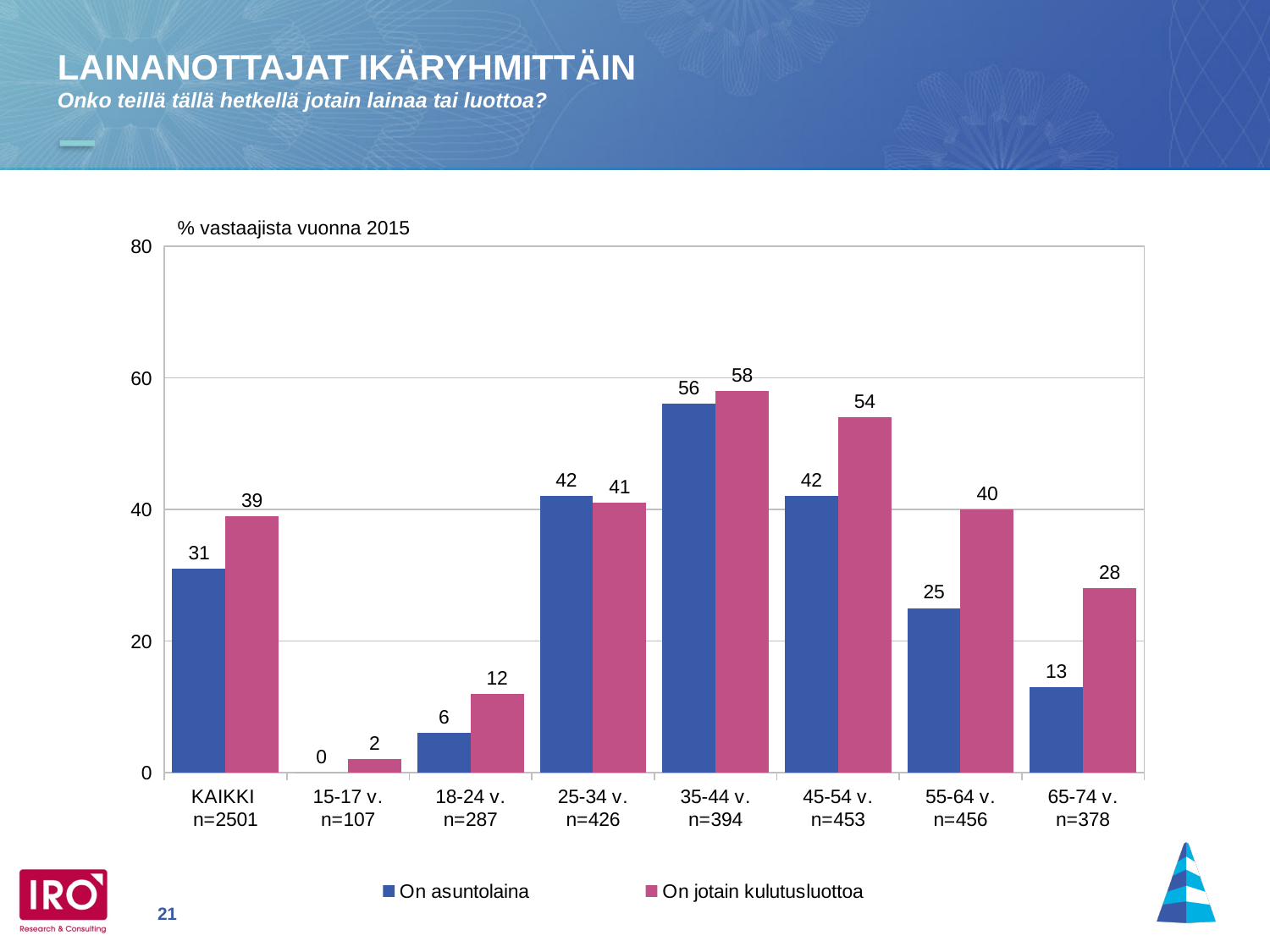
What is the value for 'On asuntolaina' in the KAIKKI n=2501 category? 31 In the 45-54 v. n=453 category, which series has the larger value, 'On asuntolaina' or 'On jotain kulutusluottoa'? On jotain kulutusluottoa What is the label shown above the chart's y axis? % vastaajista vuonna 2015 Which age category has the highest value for 'On jotain kulutusluottoa'? 35-44 v. n=394 What kind of chart is shown on the slide? Bar chart How many series does the legend list? 2 Which category has the lowest value for 'On asuntolaina'? 15-17 v. n=107 How many categories are shown on the x axis? 8 What is the value for 'On jotain kulutusluottoa' in the 65-74 v. n=378 category? 28 What is the difference between 'On jotain kulutusluottoa' and 'On asuntolaina' in the 55-64 v. n=456 category? 15 Is the value for 'On asuntolaina' in the 35-44 v. n=394 category greater or less than 40? greater What is the value for 'On asuntolaina' in the 18-24 v. n=287 category? 6